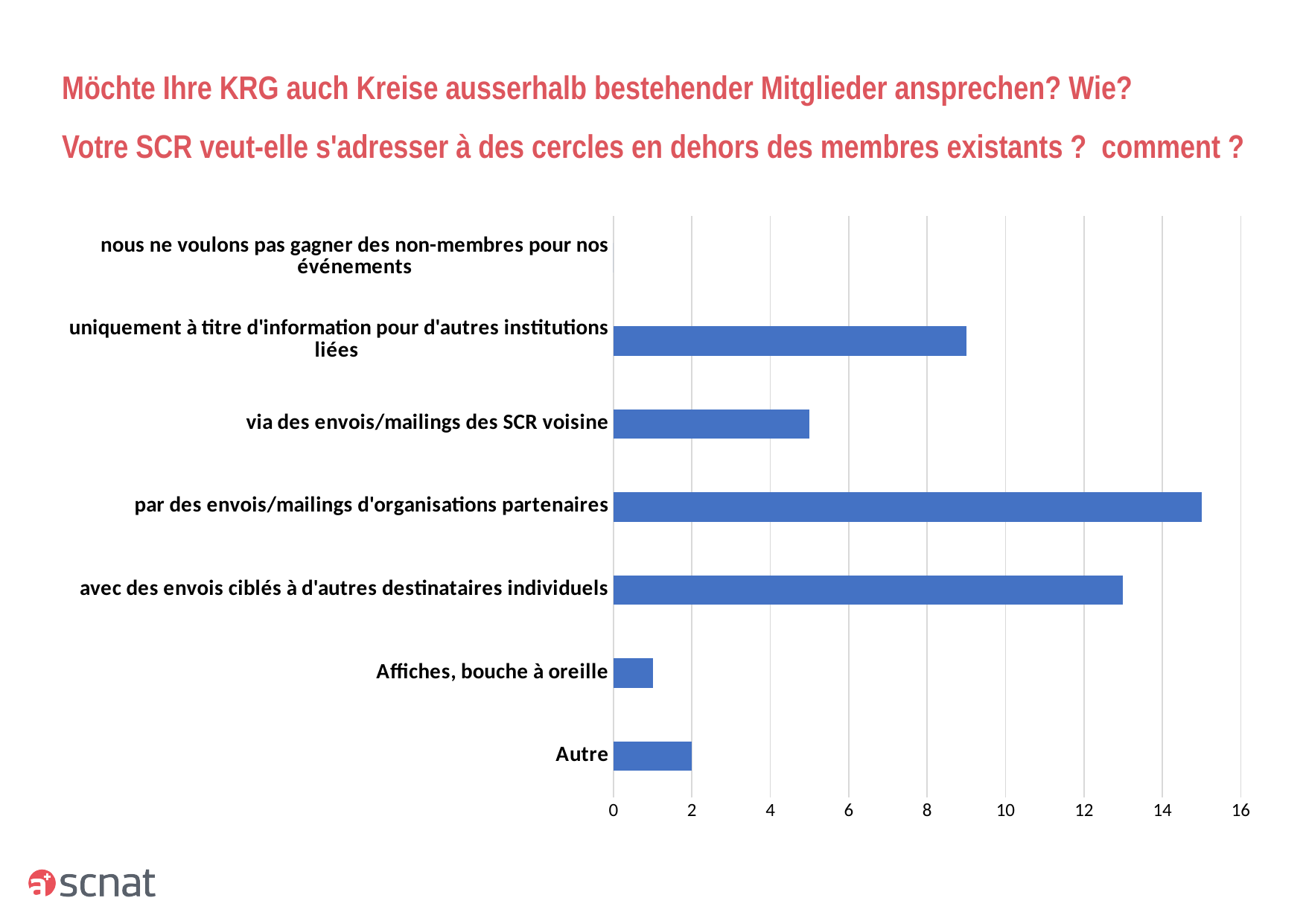
What is the value for "Autre"? 2 What kind of chart is shown on the slide? bar chart How many categories are shown on the chart? 7 Is the value for "Affiches, bouche à oreille" greater or less than 2? less Which category has the lowest value? nous ne voulons pas gagner des non-membres pour nos événements Is the value for "avec des envois ciblés à d'autres destinataires individuels" greater or less than 12? greater Which is larger: the value for "par des envois/mailings d'organisations partenaires" or for "avec des envois ciblés à d'autres destinataires individuels"? par des envois/mailings d'organisations partenaires Is the value for "par des envois/mailings d'organisations partenaires" greater or less than 14? greater What is the highest value shown on the horizontal axis? 16 Which category has the highest value? par des envois/mailings d'organisations partenaires